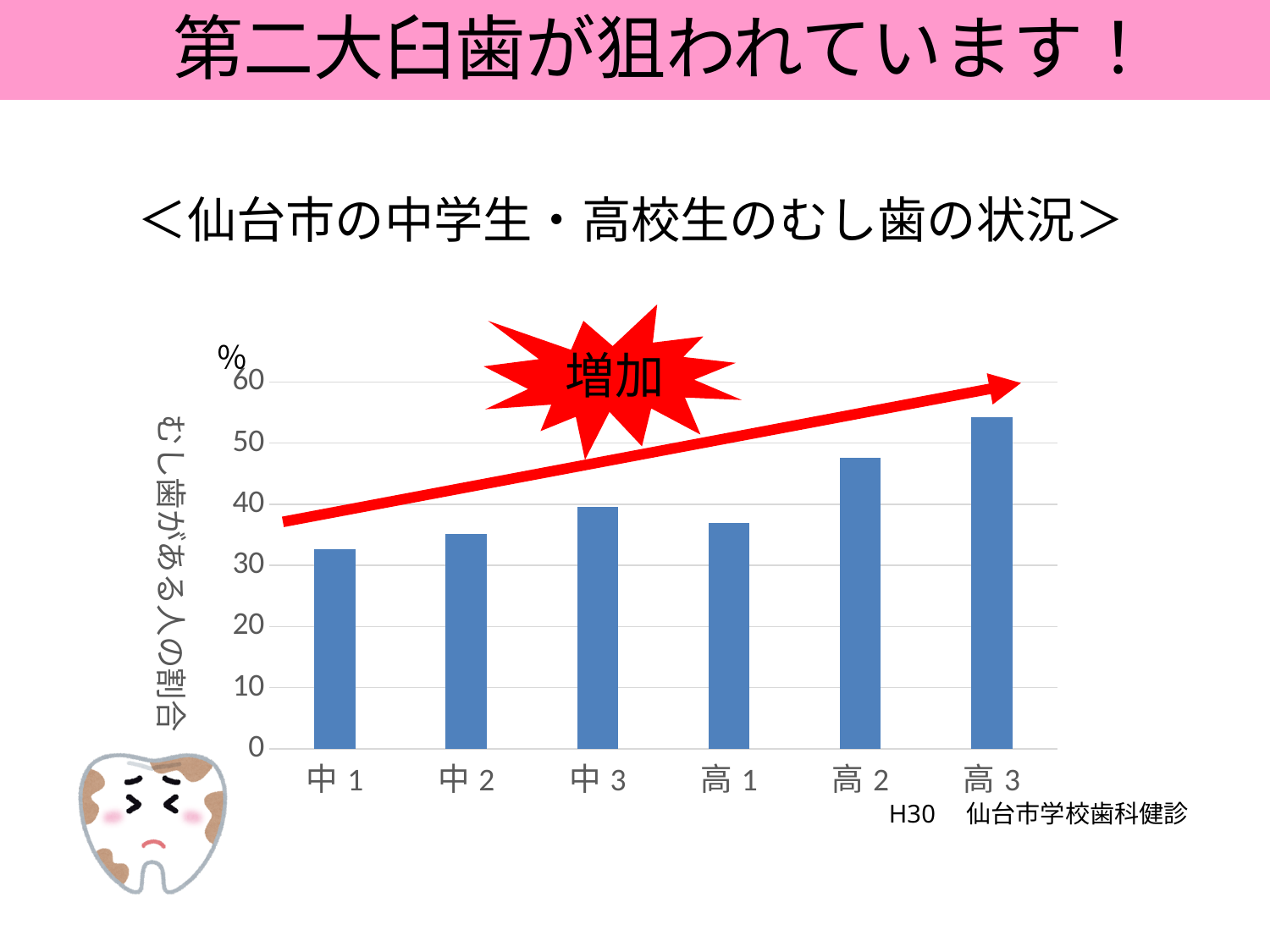
Is the value for 高２ greater or less than 50? less Which is larger, the value for 高２ or the value for 中３? 高２ What kind of chart is shown on the slide? bar chart Which is larger, the value for 中１ or the value for 高１? 高１ Which category has the lowest value? 中１ Is the value for 高３ greater or less than 50? greater Which category has the highest value? 高３ What is the label on the vertical axis? むし歯がある人の割合 How many categories are plotted on the x axis? 6 Is the value for 中１ greater or less than 30? greater Do the values generally rise or fall from 中１ to 高３? rise